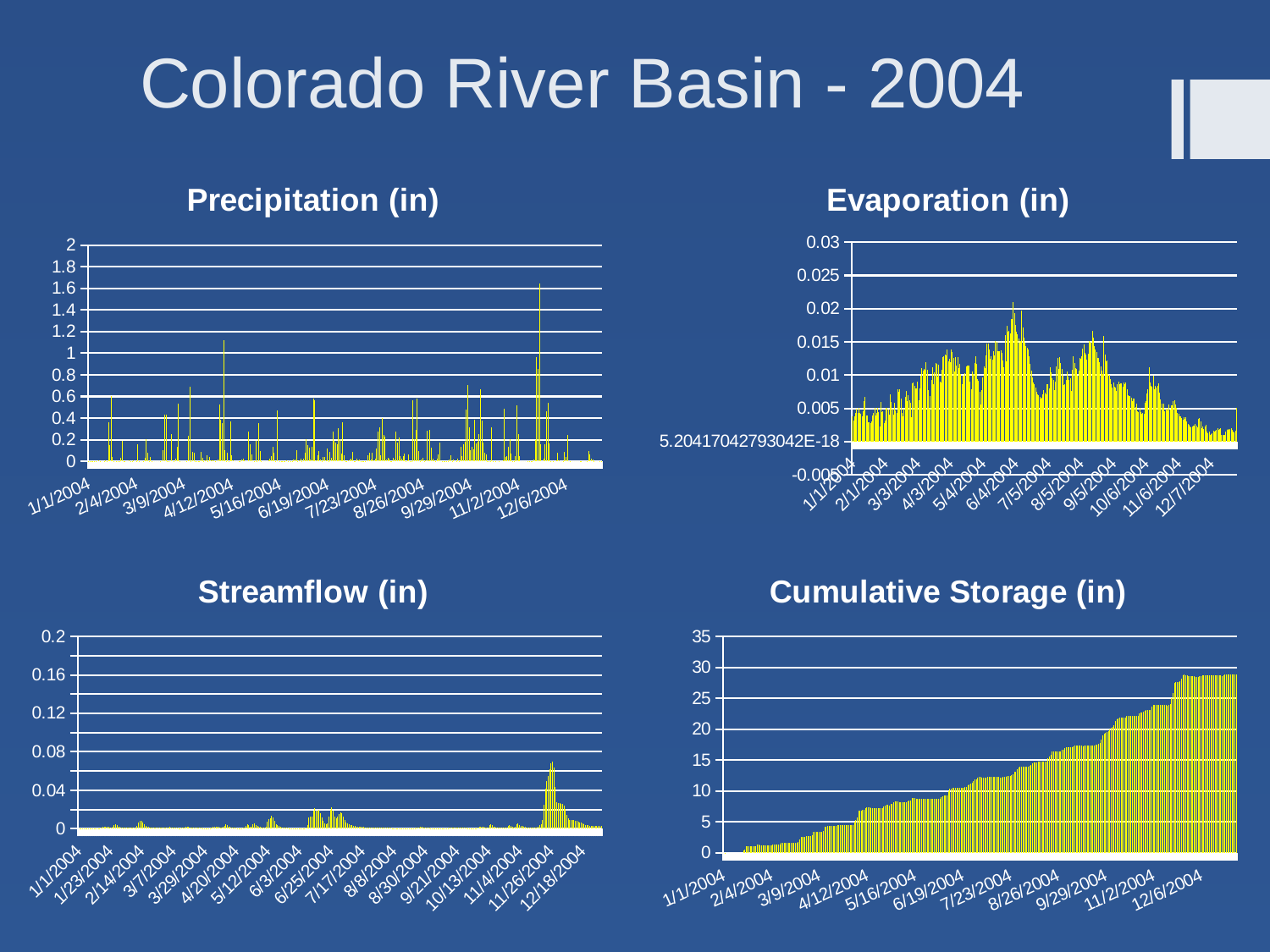
In the Streamflow (in) chart, which is larger: the peak near 6/25/2004 or the peak near 11/26/2004? 11/26/2004 How many charts are shown on the slide? 4 In the Cumulative Storage (in) chart, is the value at 12/6/2004 greater or less than 25? greater In the Streamflow (in) chart, is the highest bar greater or less than 0.08? less In the Cumulative Storage (in) chart, is the value at 3/9/2004 greater or less than 5? less In the Cumulative Storage (in) chart, do the values rise or fall along the x axis? rise What kind of chart is the Precipitation (in) chart? bar chart What is the highest value shown on the y axis of the Cumulative Storage (in) chart? 35 In the Cumulative Storage (in) chart, which is larger: the value at 1/1/2004 or the value at 12/6/2004? 12/6/2004